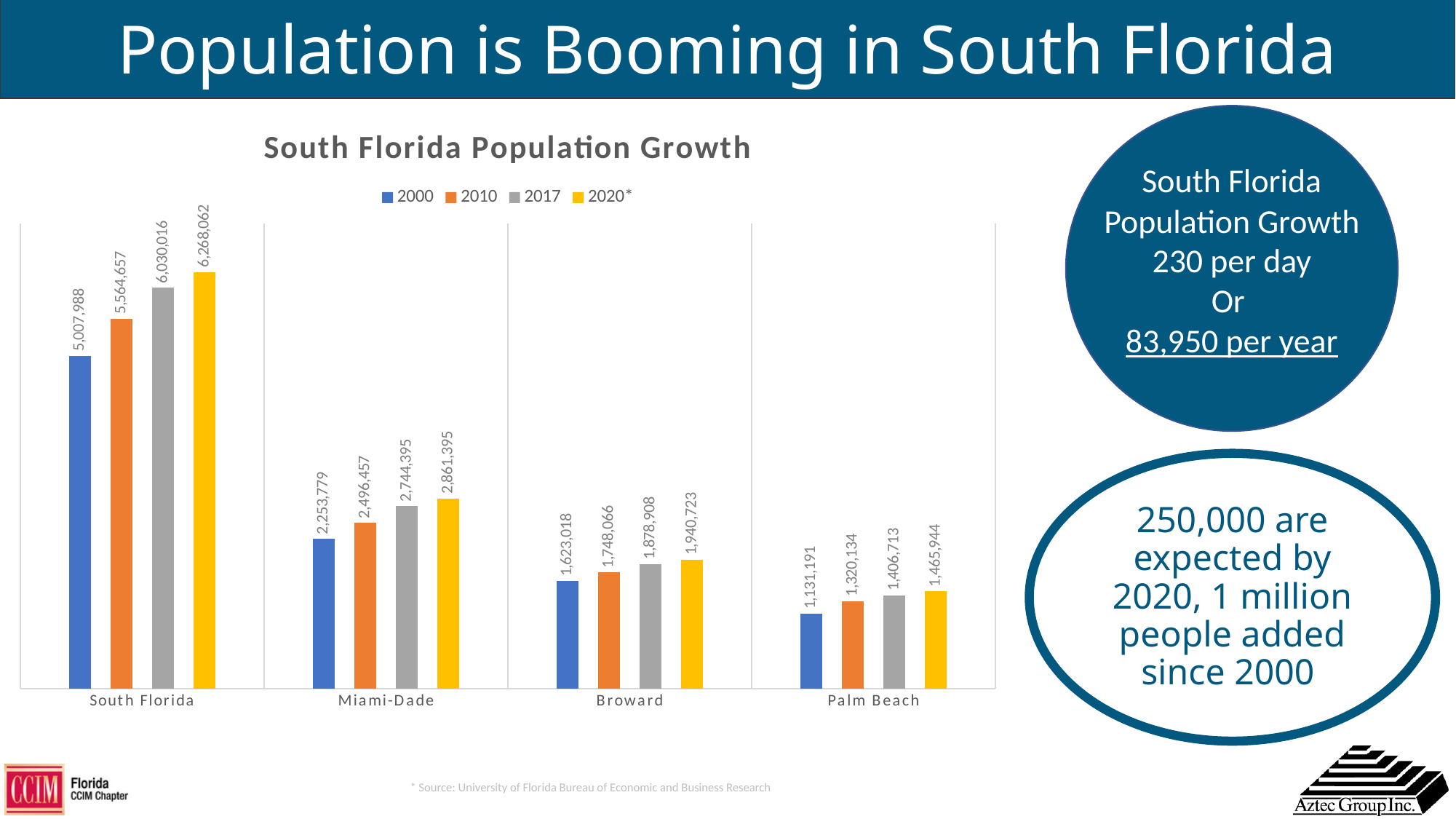
What type of chart is shown on the slide? Bar chart What is the 2017 value for Palm Beach? 1,406,713 How many series does the chart legend list? 4 How many categories are shown on the x axis of the chart? 4 Which category has the highest 2020* value? South Florida What is the 2000 value for South Florida? 5,007,988 What is the difference between the 2020* and 2000 values for Miami-Dade? 607,616 Which is larger: the 2017 value for Broward or the 2020* value for Palm Beach? 2017 value for Broward What is the title of the chart? South Florida Population Growth Which category has the lowest 2010 value? Palm Beach Do the values for Broward rise or fall from 2000 to 2020*? Rise What is the 2020* value for Miami-Dade? 2,861,395